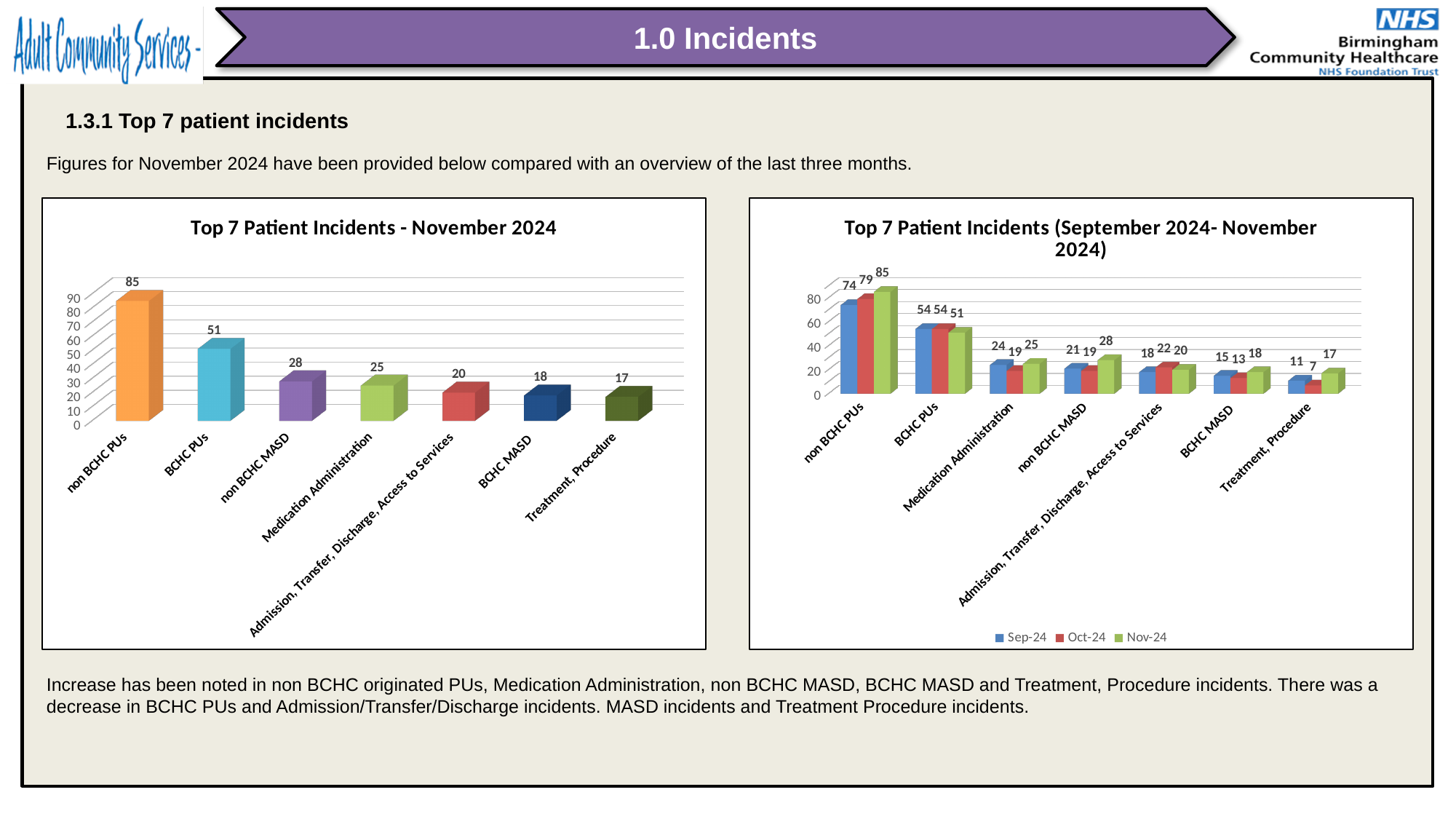
In the 'Top 7 Patient Incidents - November 2024' chart, which category has the lowest value? Treatment, Procedure In the 'Top 7 Patient Incidents (September 2024- November 2024)' chart, how many series does the legend list? 3 In the 'Top 7 Patient Incidents - November 2024' chart, how many categories are shown? 7 In the 'Top 7 Patient Incidents (September 2024- November 2024)' chart, what is the Sep-24 value for non BCHC PUs? 74 In the 'Top 7 Patient Incidents - November 2024' chart, what is the value for non BCHC PUs? 85 In the 'Top 7 Patient Incidents (September 2024- November 2024)' chart, which series is shown in green? Nov-24 In the 'Top 7 Patient Incidents - November 2024' chart, what is the value for Medication Administration? 25 In the 'Top 7 Patient Incidents (September 2024- November 2024)' chart, what is the difference between the Oct-24 and Nov-24 values for BCHC MASD? 5 In the 'Top 7 Patient Incidents - November 2024' chart, what is the difference between non BCHC PUs and BCHC PUs? 34 In the 'Top 7 Patient Incidents (September 2024- November 2024)' chart, what is the Oct-24 value for Treatment, Procedure? 7 What kind of chart is the 'Top 7 Patient Incidents - November 2024' chart? Bar chart In the 'Top 7 Patient Incidents (September 2024- November 2024)' chart, which is larger for non BCHC MASD: Sep-24 or Nov-24? Nov-24